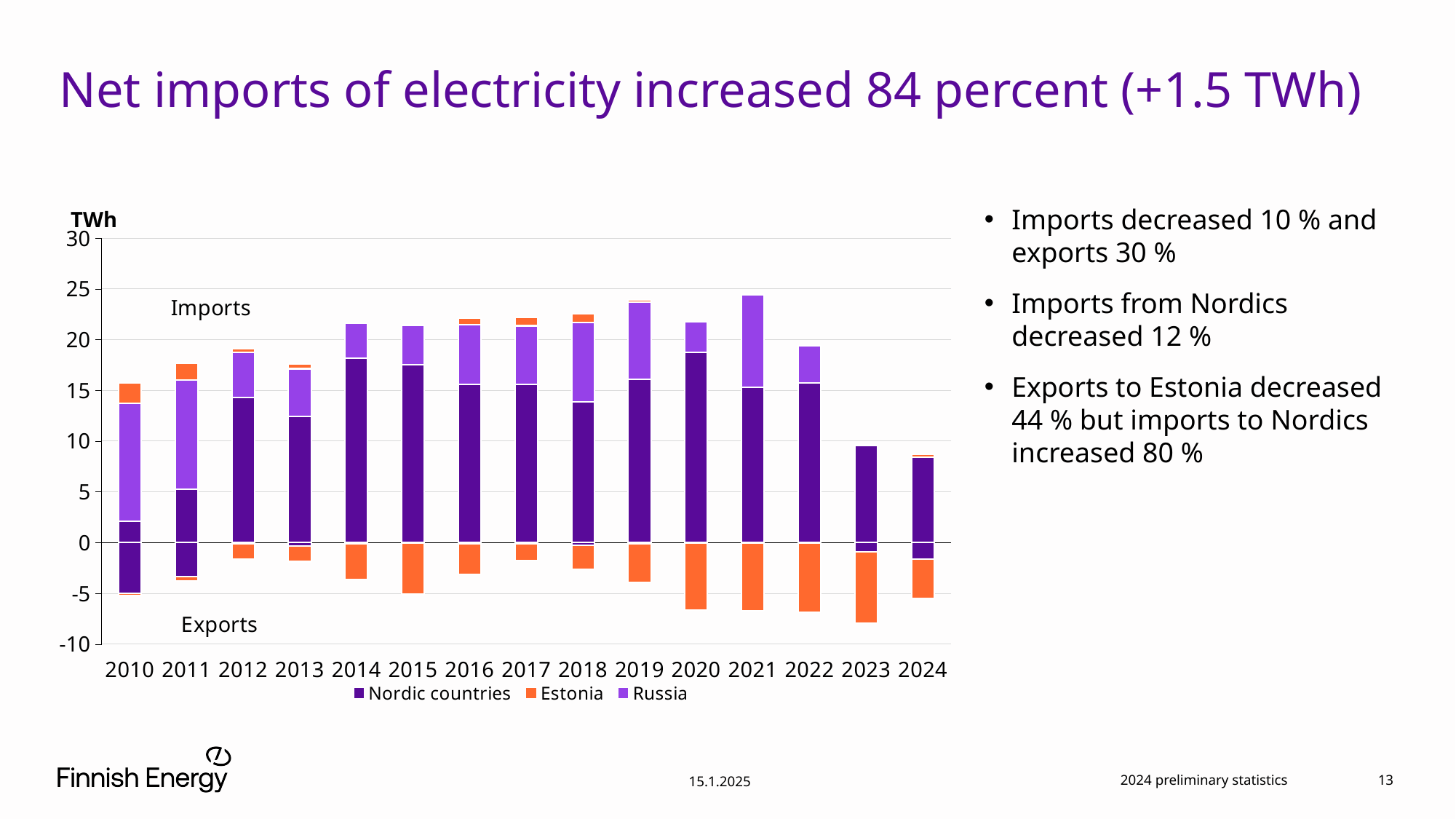
Is the total exports value for 2023 greater or less than -5? less Is the total imports value for 2021 greater or less than 20? greater How many series does the chart legend list? 3 Is the Nordic countries imports value for 2020 greater or less than 15? greater Which year had larger total exports, 2020 or 2012? 2020 What kind of chart is shown on the slide? bar chart Which series are listed in the chart legend? Nordic countries, Estonia, Russia How many years are shown on the x axis of the chart? 15 Do total imports rise or fall from 2021 to 2024? fall What unit is shown on the y axis of the chart? TWh